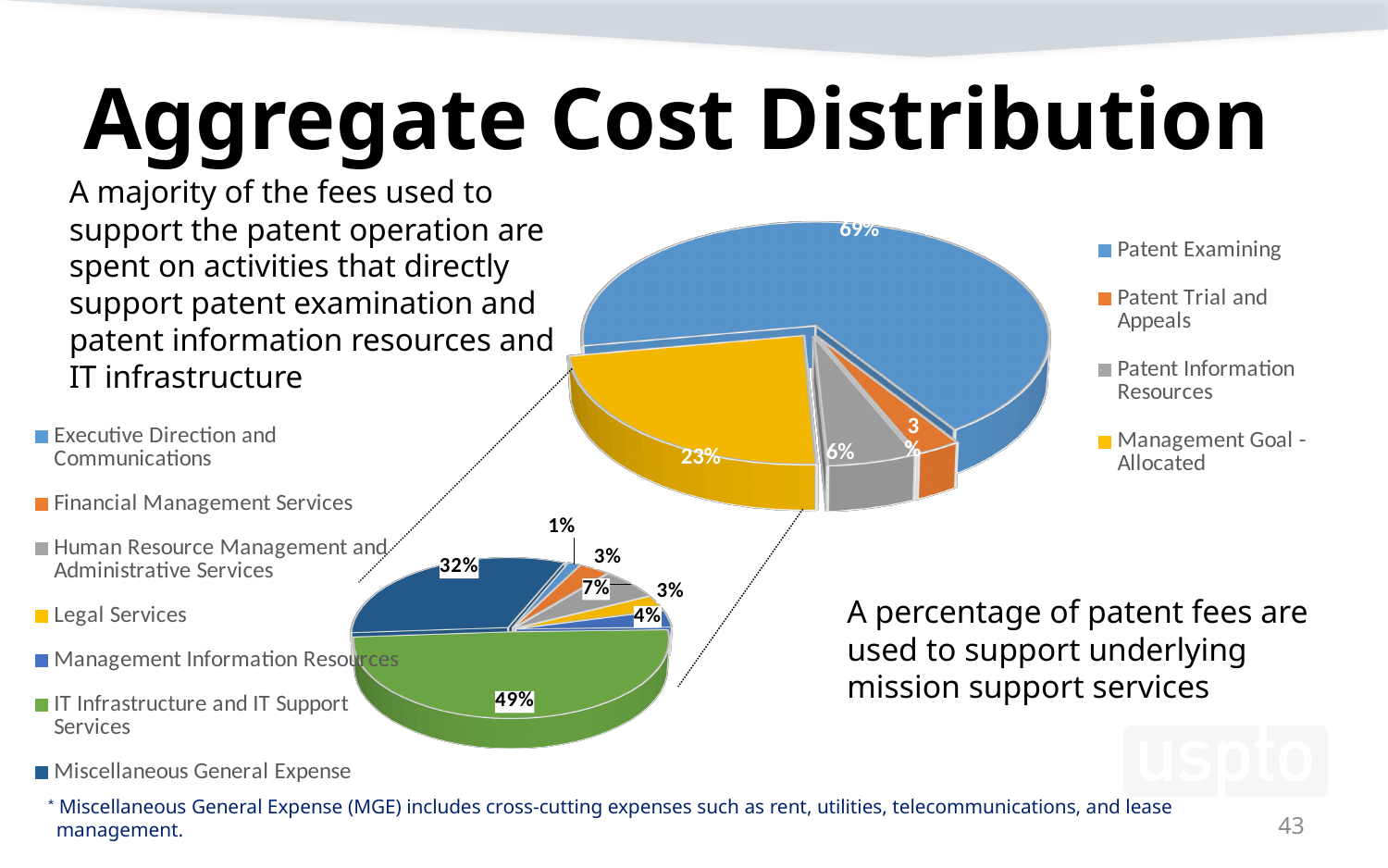
In the lower-left pie chart, what percentage is shown for Miscellaneous General Expense? 32% In the lower-left pie chart, which category has the largest share? IT Infrastructure and IT Support Services In the upper-right pie chart, what percentage is shown for Management Goal - Allocated? 23% In the upper-right pie chart, what percentage is shown for Patent Examining? 69% In the upper-right pie chart, what is the difference between the Patent Examining share and the Management Goal - Allocated share? 46% What type of chart is used on this slide? Pie chart In the lower-left pie chart, what percentage is shown for IT Infrastructure and IT Support Services? 49% In the upper-right pie chart, which category has the smallest share? Patent Trial and Appeals How many categories does the legend of the lower-left pie chart list? 7 How many categories does the legend of the upper-right pie chart list? 4 In the upper-right pie chart, what percentage is shown for Patent Information Resources? 6% In the upper-right pie chart, which category has the largest share? Patent Examining